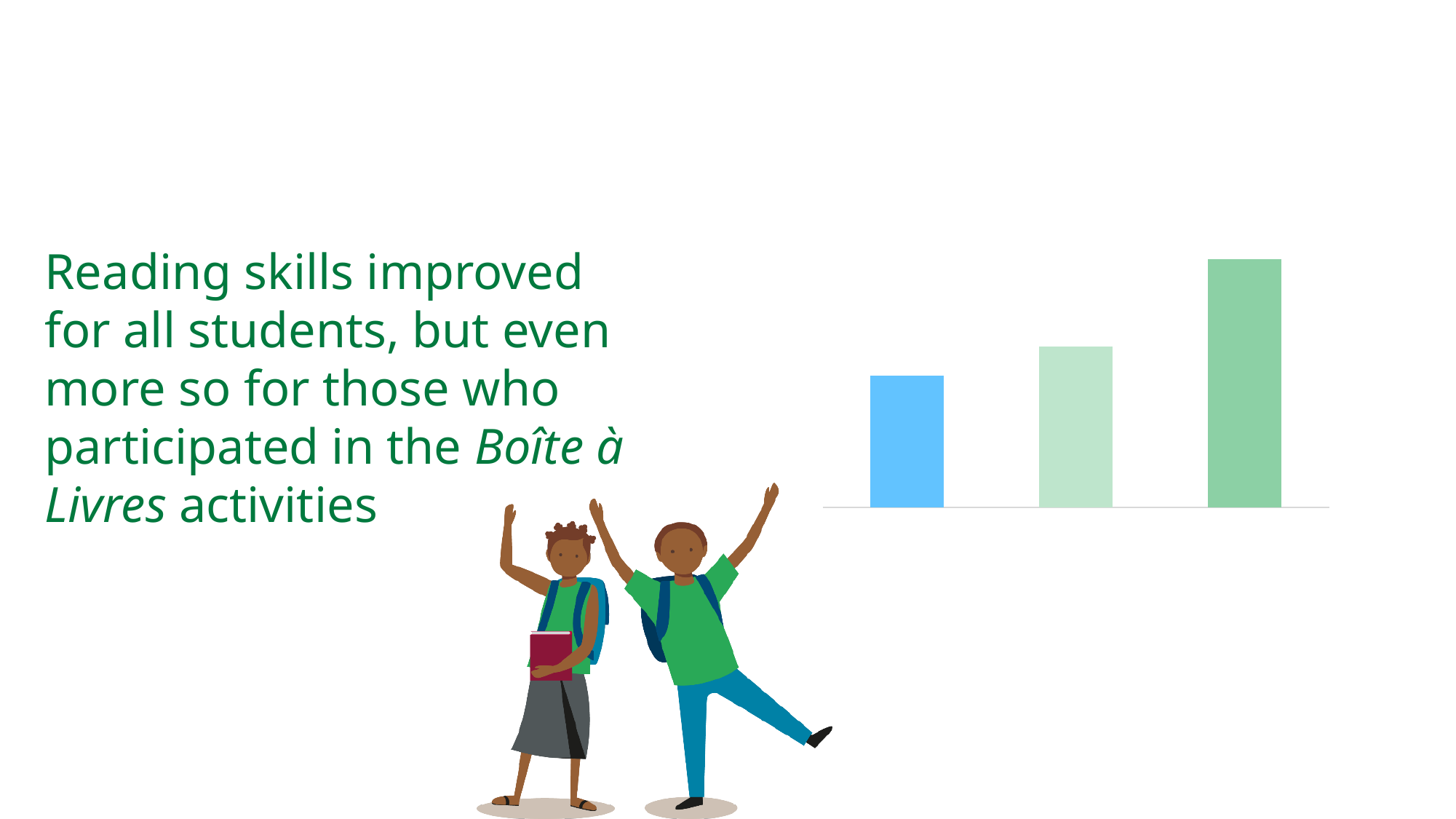
Which bar in the chart is the shortest: the leftmost, middle, or rightmost? leftmost What colour are the middle and rightmost bars in the chart? green Is the rightmost bar taller or shorter than the leftmost bar? taller How many bars does the chart on the slide have? 3 What colour is the leftmost bar in the chart? blue Which bar in the chart is the tallest: the leftmost, middle, or rightmost? rightmost Do the bar heights rise or fall from left to right across the chart? rise What kind of chart is shown on the right of the slide? bar chart Is the middle bar taller or shorter than the rightmost bar? shorter